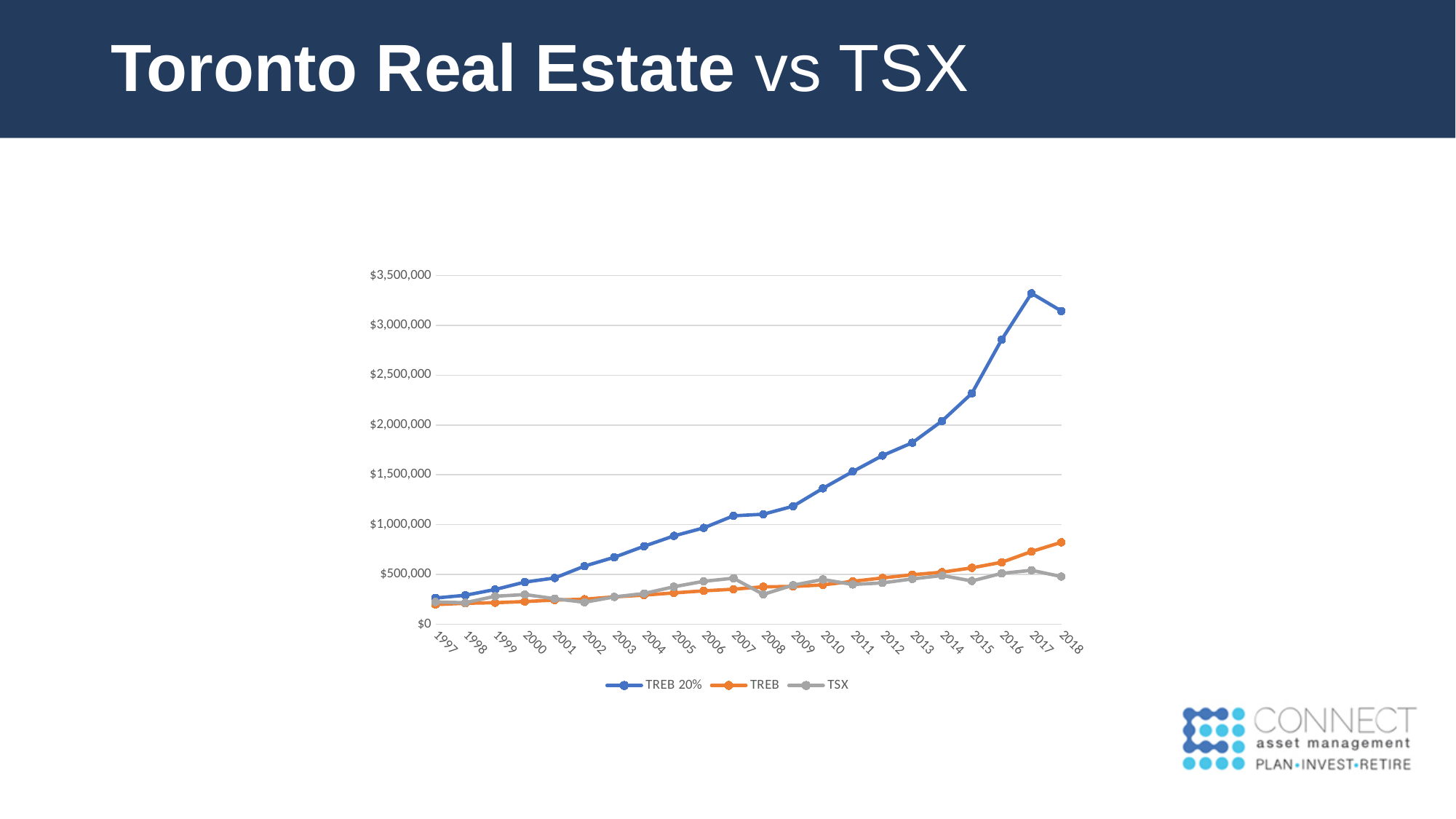
How many series does the legend list? 3 What kind of chart is shown on the slide? Line chart Is the value for TREB in 2018 greater or less than $1,000,000? less What are the three series named in the legend? TREB 20%, TREB, TSX Which series has the highest value in 2018? TREB 20% Is the value for TREB 20% in 2016 greater or less than $2,500,000? greater In which year does the TREB 20% series reach its highest value? 2017 How many years are plotted along the x axis? 22 Which is larger in 2018, the TREB value or the TSX value? TREB Does the TREB 20% series rise or fall from 2017 to 2018? Fall Is the value for TREB 20% in 2010 greater or less than $1,500,000? less